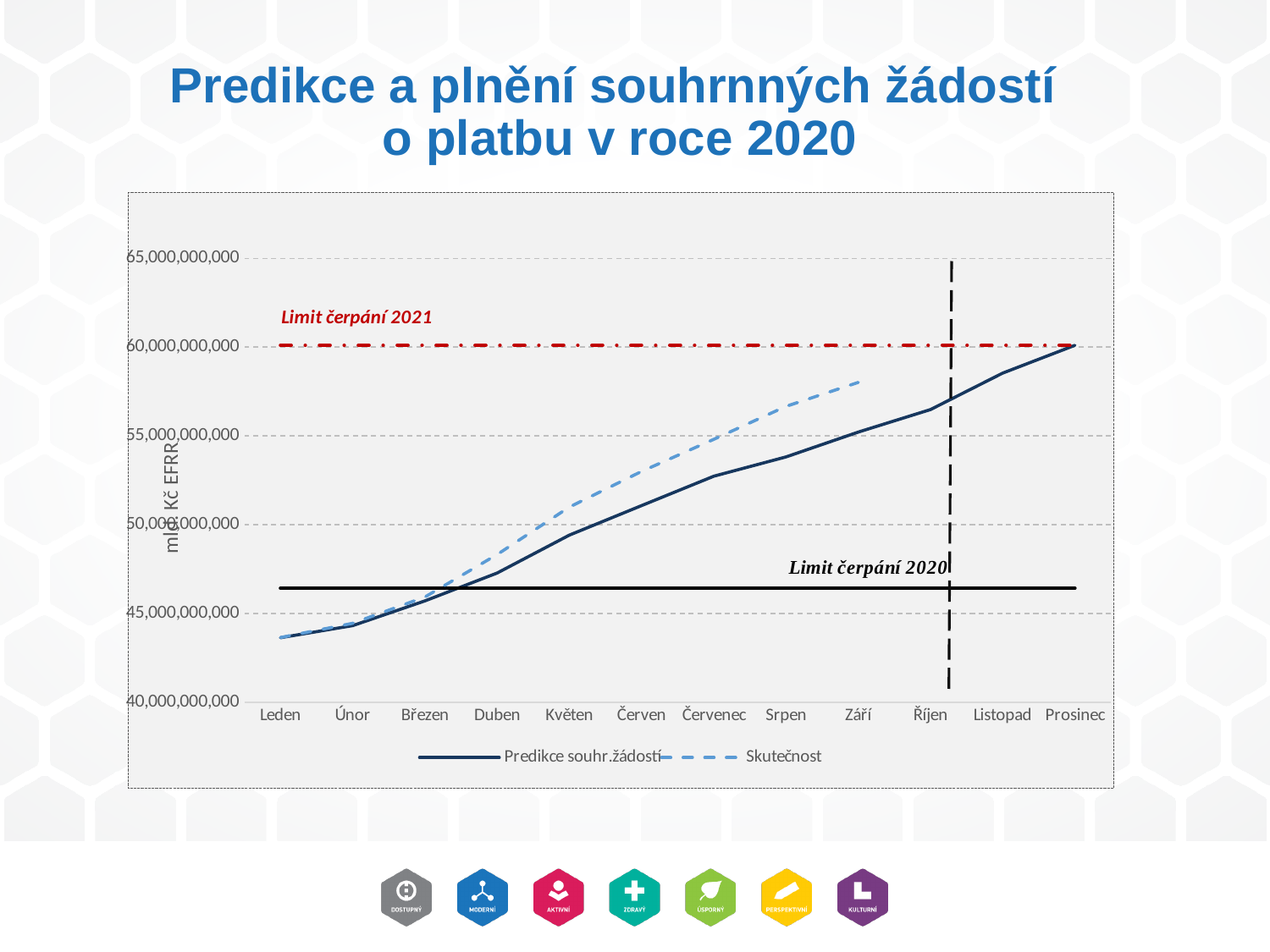
Does the Predikce souhr.žádostí line rise or fall from Leden to Prosinec? rises In Září, which series has the higher value, Predikce souhr.žádostí or Skutečnost? Skutečnost Is the value of Predikce souhr.žádostí in Leden greater or less than 45,000,000,000? less In which month does the Predikce souhr.žádostí series reach its highest value? Prosinec Is the value of Predikce souhr.žádostí in Červenec greater or less than 55,000,000,000? less How many months are shown on the x axis of the chart? 12 Which month does the vertical black dashed line in the chart mark? Říjen In which month does the Predikce souhr.žádostí series have its lowest value? Leden Is the value of Skutečnost in Září greater or less than 55,000,000,000? greater What kind of chart is shown on the slide? line chart How many series does the chart legend list? 2